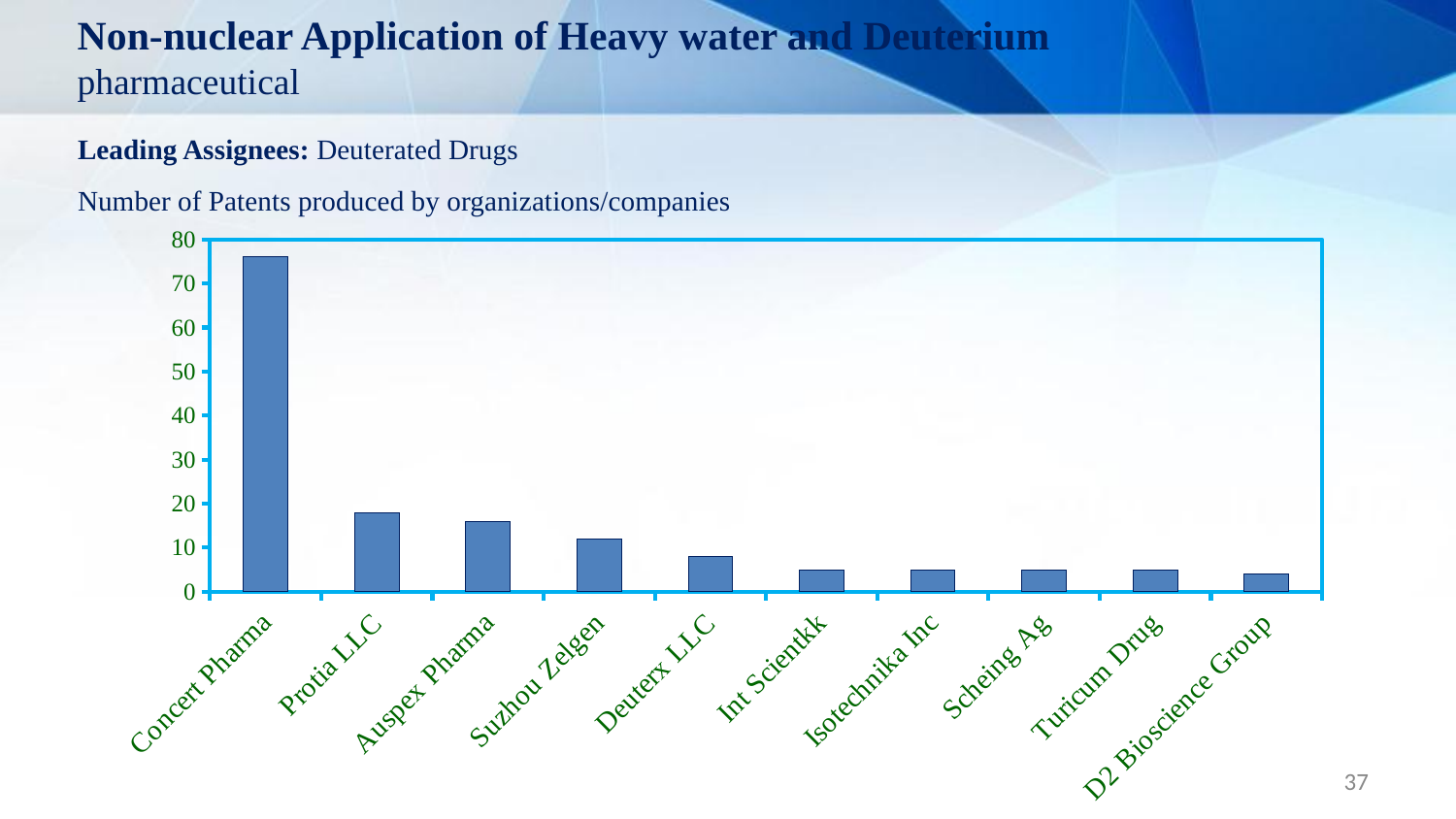
Is the value for Concert Pharma greater or less than 70? greater Do the bar values generally rise or fall from left to right along the x axis? fall Is the value for Suzhou Zelgen greater or less than 20? less Is the value for Auspex Pharma greater or less than 10? greater Which organization has the highest number of patents in the chart? Concert Pharma Which has more patents, Protia LLC or Suzhou Zelgen? Protia LLC Which has more patents, Concert Pharma or Auspex Pharma? Concert Pharma What kind of chart is shown on the slide? bar chart How many organizations/companies are shown on the x axis of the chart? 10 What is the highest value shown on the y axis of the chart? 80